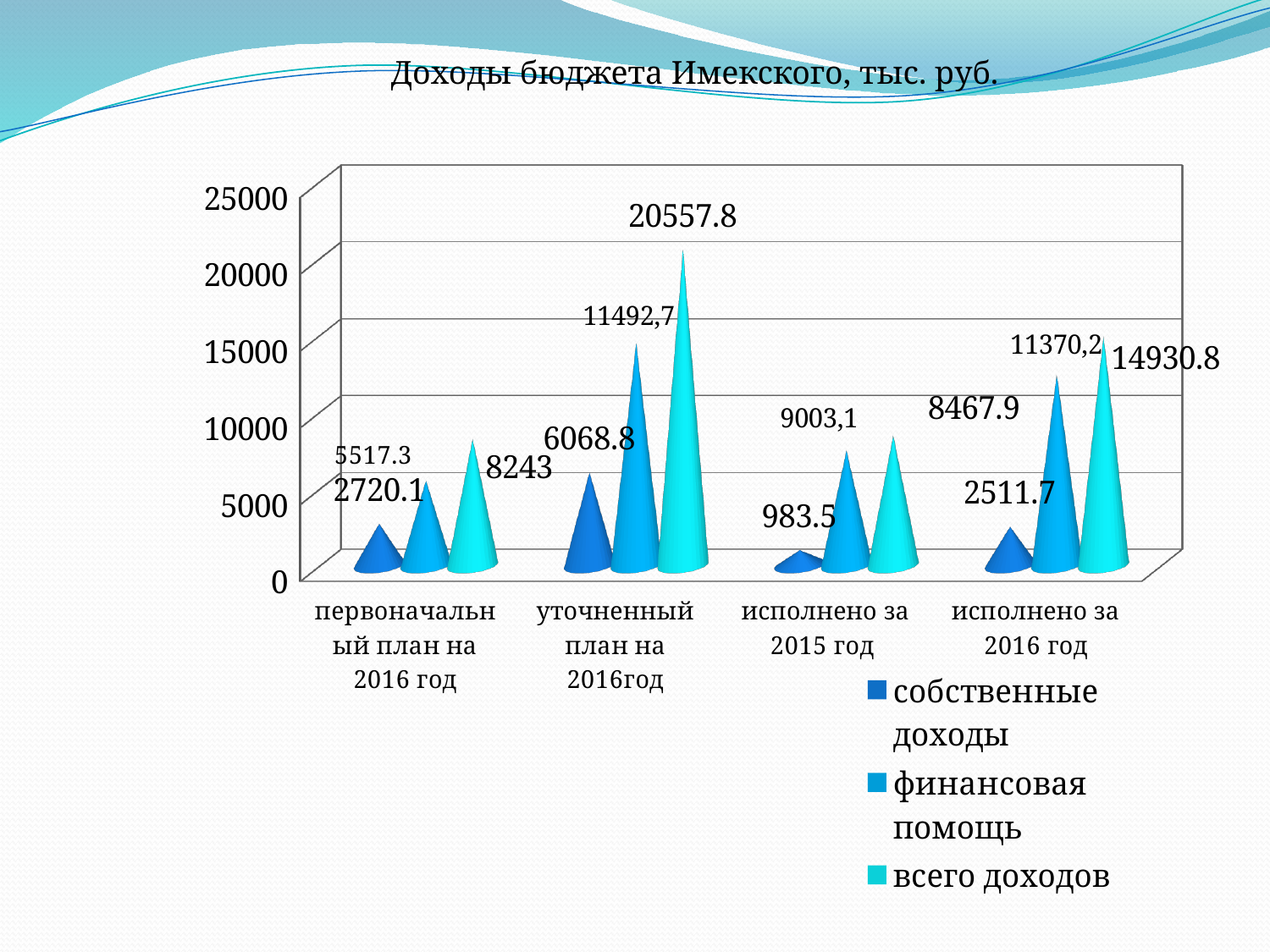
What is the value of собственные доходы for исполнено за 2015 год? 983.5 Which category has the lowest value for собственные доходы? исполнено за 2015 год What is the value of финансовая помощь for исполнено за 2016 год? 11370,2 How many categories are shown on the x axis? 4 Which is larger: собственные доходы for уточненный план на 2016год or for исполнено за 2016 год? уточненный план на 2016год What is the title of the chart? Доходы бюджета Имекского, тыс. руб. What is the value of всего доходов for уточненный план на 2016год? 20557.8 How many series does the legend list? 3 What is the value of всего доходов for исполнено за 2016 год? 14930.8 What is the value of собственные доходы for первоначальный план на 2016 год? 2720.1 What is the difference between всего доходов for уточненный план на 2016год and for исполнено за 2016 год? 5627 Which category has the highest value for всего доходов? уточненный план на 2016год